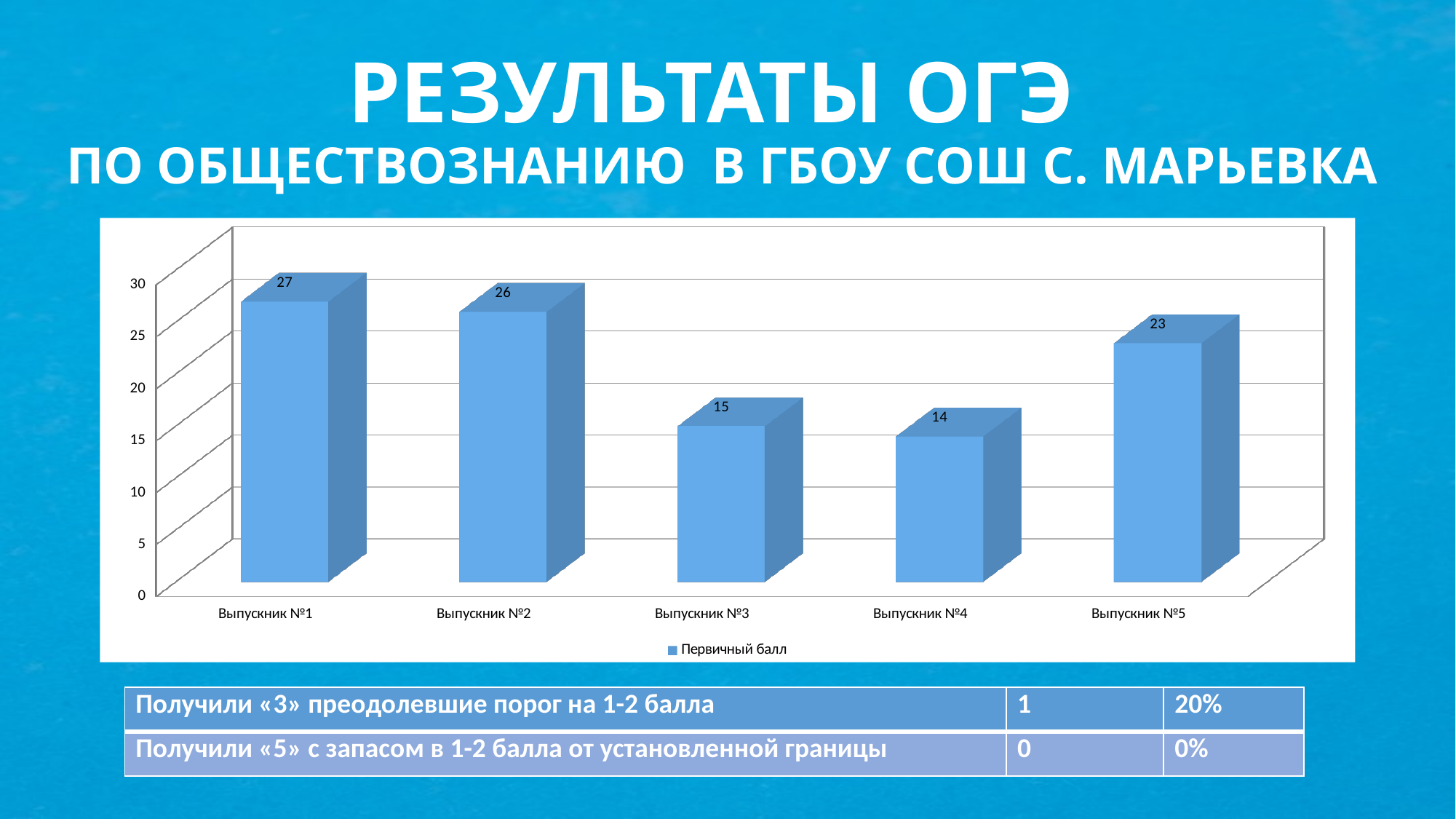
Is the value for Выпускник №2 greater or less than 20? greater Which is larger, the value for Выпускник №3 or Выпускник №5? Выпускник №5 How many categories are shown on the x axis? 5 What is the value for Выпускник №3? 15 What is the value for Выпускник №5? 23 What series name is listed in the legend? Первичный балл Which category has the highest value? Выпускник №1 What is the value for Выпускник №1? 27 What is the difference between the values for Выпускник №1 and Выпускник №4? 13 Which category has the lowest value? Выпускник №4 What kind of chart is shown on the slide? bar chart What is the difference between the values for Выпускник №2 and Выпускник №5? 3